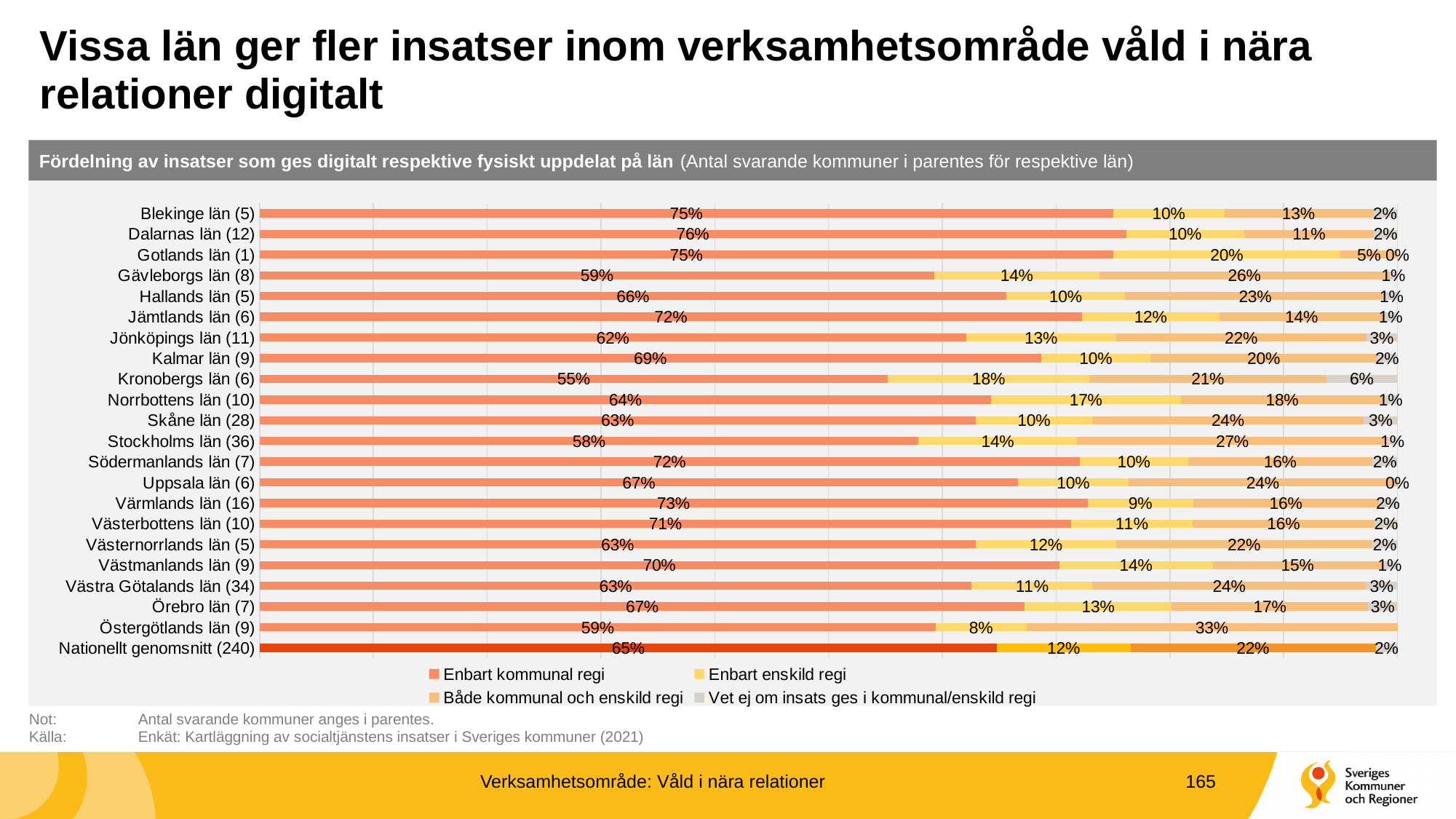
How many categories (rows) are shown in the chart? 22 Which has a larger 'Enbart kommunal regi' share, Gävleborgs län (8) or Hallands län (5)? Hallands län (5) What is the 'Vet ej om insats ges i kommunal/enskild regi' value for Kronobergs län (6)? 6% What is the 'Enbart enskild regi' value for Nationellt genomsnitt (240)? 12% Which län has the highest 'Enbart kommunal regi' share? Dalarnas län (12) What percentage of insatser in Blekinge län (5) are given 'Enbart kommunal regi'? 75% Which län has the highest 'Enbart enskild regi' share? Gotlands län (1) What is the difference in 'Enbart kommunal regi' share between Dalarnas län (12) and Kronobergs län (6)? 21 percentage points What kind of chart is shown on the slide? Stacked bar chart Which län has the lowest 'Enbart kommunal regi' share? Kronobergs län (6) How many series does the legend list? 4 What is the 'Både kommunal och enskild regi' value for Östergötlands län (9)? 33%